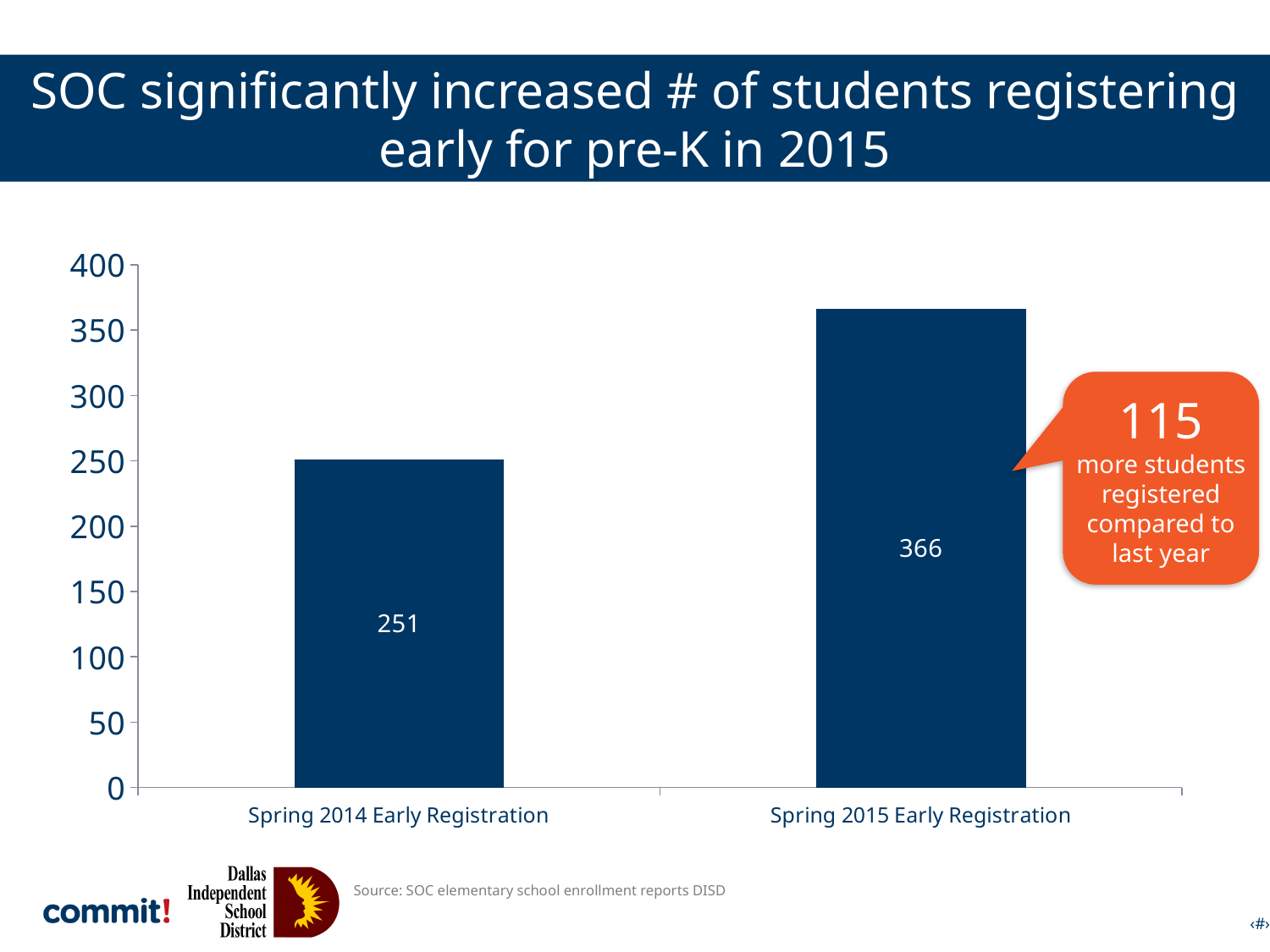
What is the value for Spring 2015 Early Registration? 366 What kind of chart is shown on the slide? Bar chart What is the difference between the Spring 2015 and Spring 2014 Early Registration values? 115 What is the maximum value shown on the vertical axis? 400 Which category has the highest value? Spring 2015 Early Registration Which category has the lowest value? Spring 2014 Early Registration How many categories are shown on the x axis? 2 Is the value for Spring 2014 Early Registration greater or less than 300? less Do the values rise or fall from Spring 2014 to Spring 2015? Rise Is the value for Spring 2015 Early Registration greater or less than 350? greater Which is larger, the value for Spring 2014 Early Registration or Spring 2015 Early Registration? Spring 2015 Early Registration What is the value for Spring 2014 Early Registration? 251